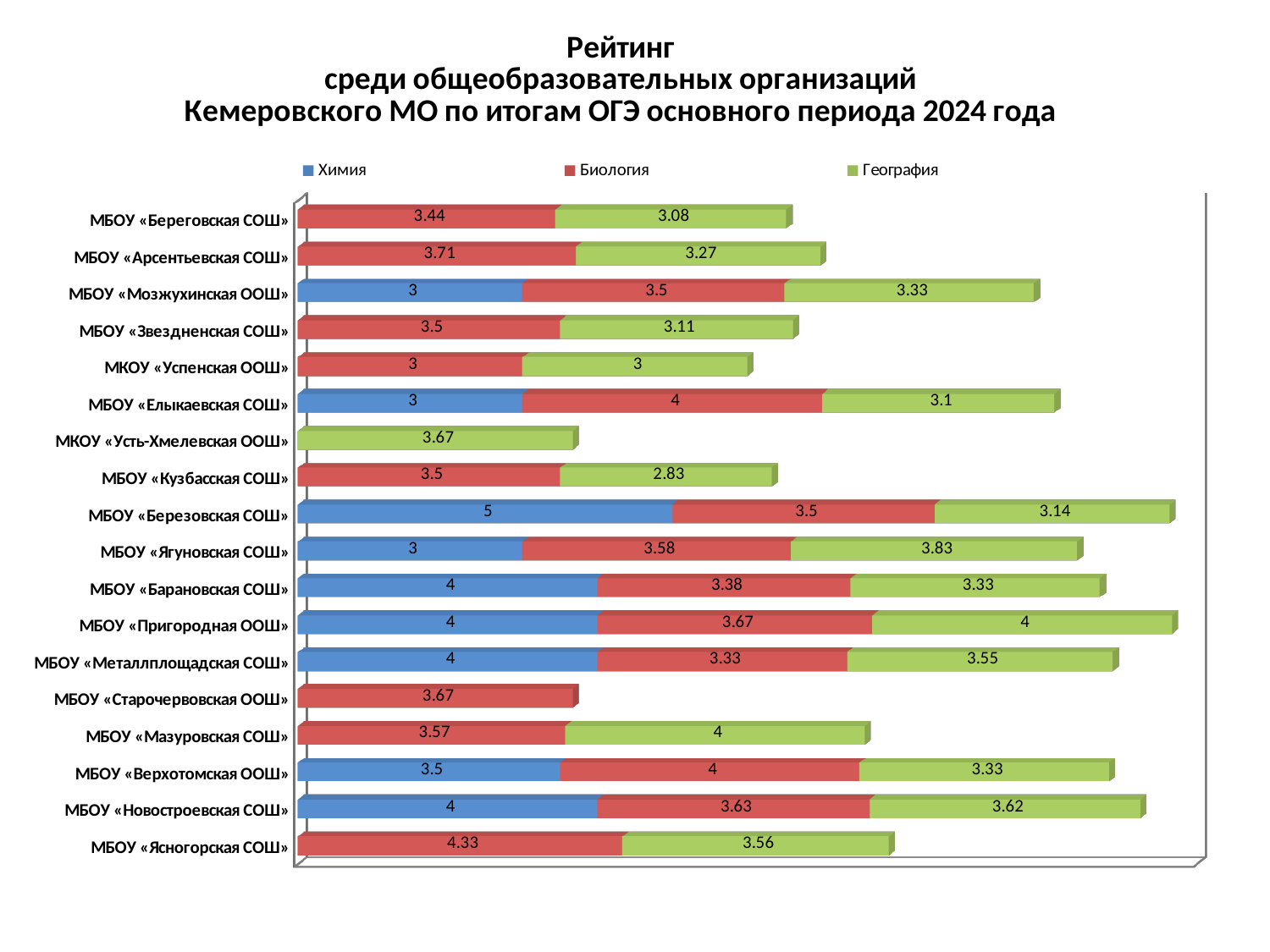
What is the difference between the Биология and Химия values for МБОУ «Елыкаевская СОШ»? 1 Which colour represents География in the legend? Green Which school has the lowest География value? МБОУ «Кузбасская СОШ» What is the География value for МБОУ «Ягуновская СОШ»? 3.83 How many schools are listed on the chart? 18 Which school has the highest Химия value? МБОУ «Березовская СОШ» What is the Биология value for МБОУ «Ясногорская СОШ»? 4.33 Which is larger: the Биология value for МБОУ «Арсентьевская СОШ» or for МБОУ «Звездненская СОШ»? МБОУ «Арсентьевская СОШ» What is the total of the stacked bar for МБОУ «Мозжухинская ООШ»? 9.83 How many series does the legend list? 3 What kind of chart is shown on the slide? Stacked bar chart What is the Химия value for МБОУ «Березовская СОШ»? 5